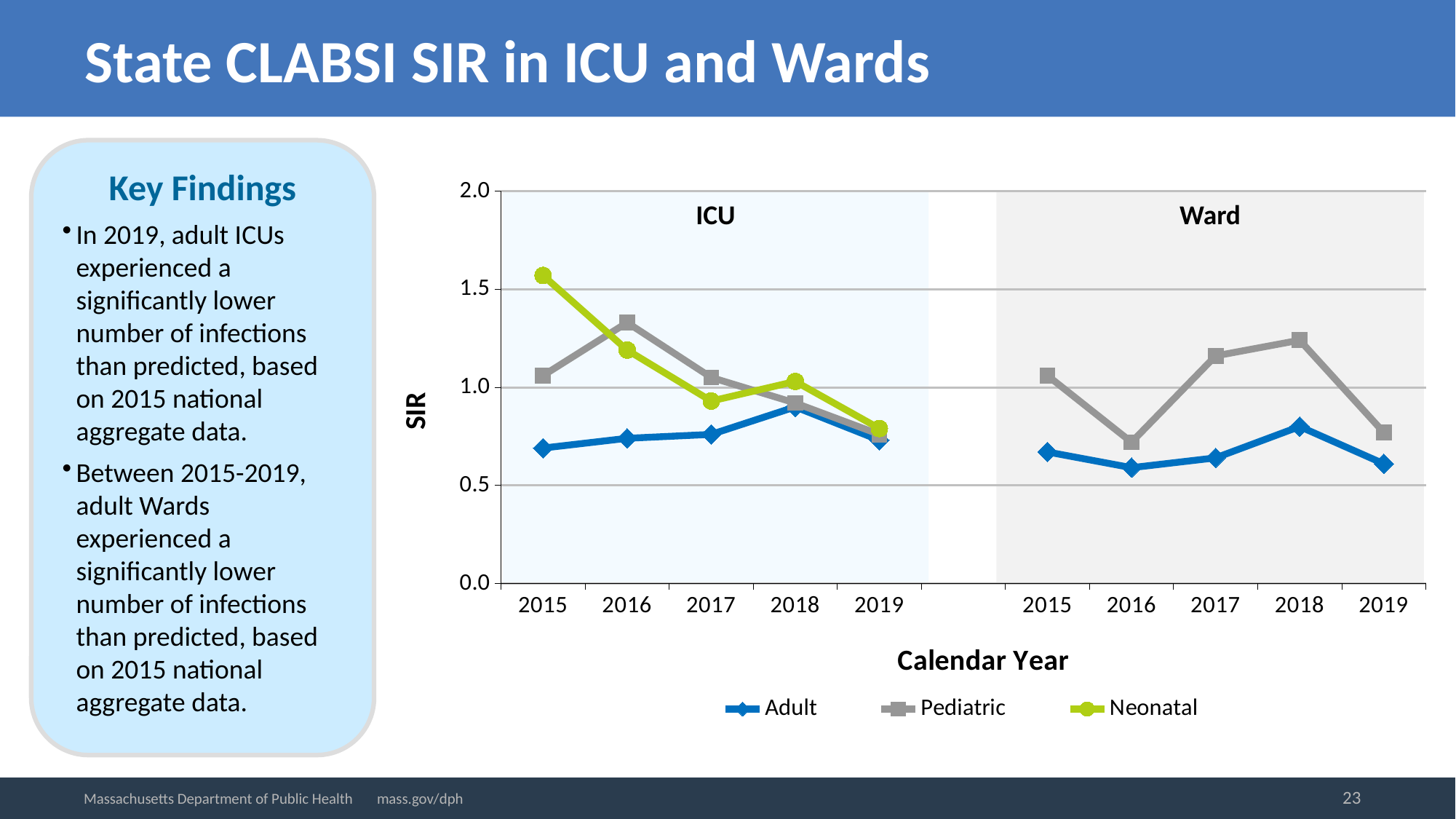
In which year was the Adult SIR in the ICU highest? 2018 In the Ward for 2017, which series has the larger SIR, Pediatric or Adult? Pediatric In which year was the Pediatric SIR in the ICU highest? 2016 How many series does the legend list? 3 Is the Pediatric SIR in the Ward for 2016 greater or less than 1.0? less In the ICU for 2015, which series has the larger SIR, Neonatal or Pediatric? Neonatal What is the title of the x axis? Calendar Year Is the Neonatal SIR in the ICU for 2015 greater or less than 1.5? greater In which year was the Pediatric SIR in the Ward highest? 2018 What kind of chart is shown on the slide? line chart Is the Adult SIR in the ICU for 2018 greater or less than 1.0? less Does the Neonatal SIR in the ICU rise or fall from 2015 to 2017? fall